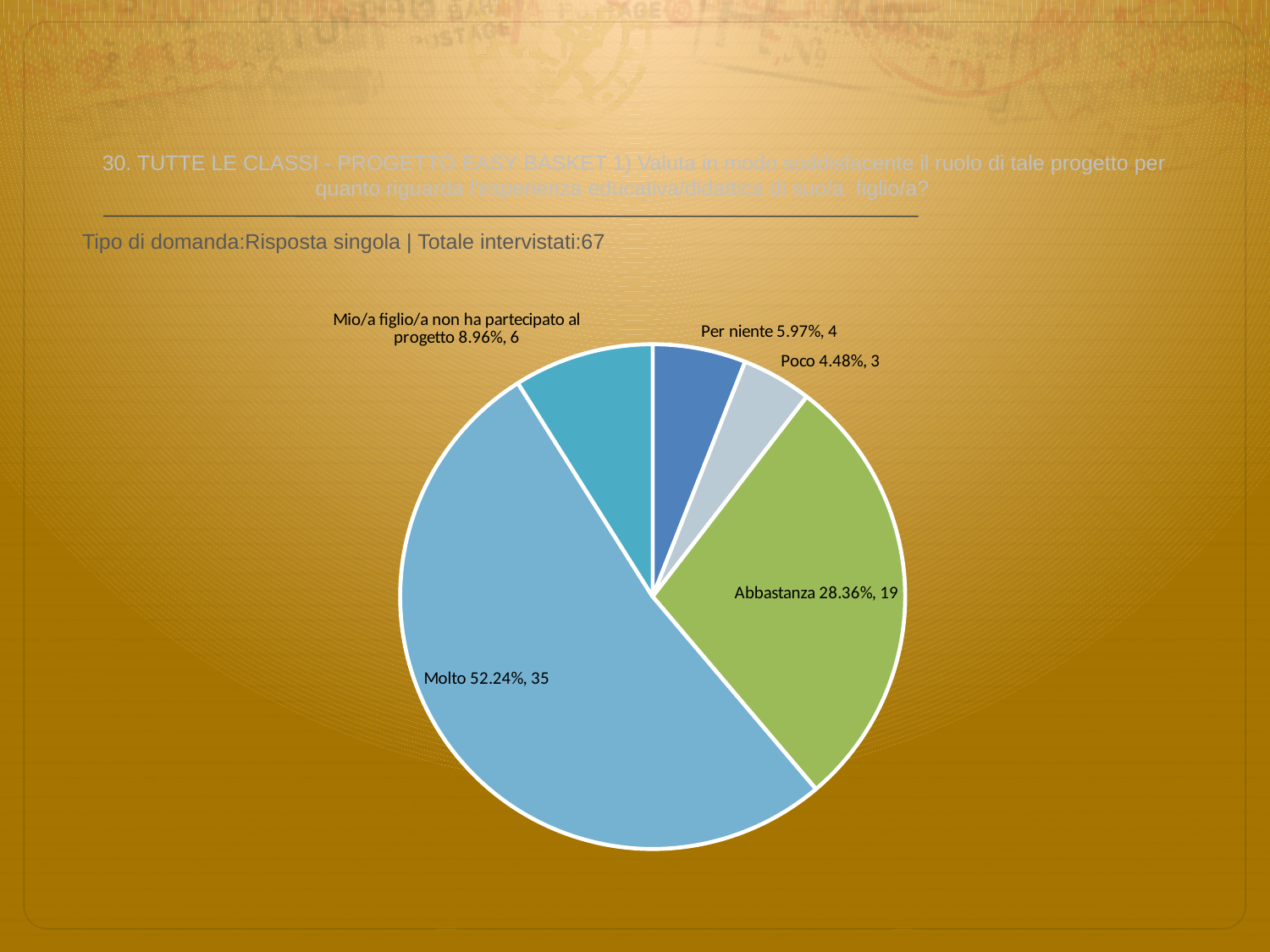
Which category has the smallest slice of the pie? Poco How many respondents answered "Per niente"? 4 What kind of chart is shown on the slide? pie chart Which category has the largest slice of the pie? Molto What is the difference in number of respondents between "Molto" and "Abbastanza"? 16 Which has more respondents, "Per niente" or "Poco"? Per niente What percentage is shown for "Mio/a figlio/a non ha partecipato al progetto"? 8.96% What is the total number of respondents stated on the slide? 67 What percentage of respondents answered "Molto"? 52.24% How many slices does the pie chart have? 5 How many respondents answered "Abbastanza"? 19 What percentage of respondents answered "Poco"? 4.48%